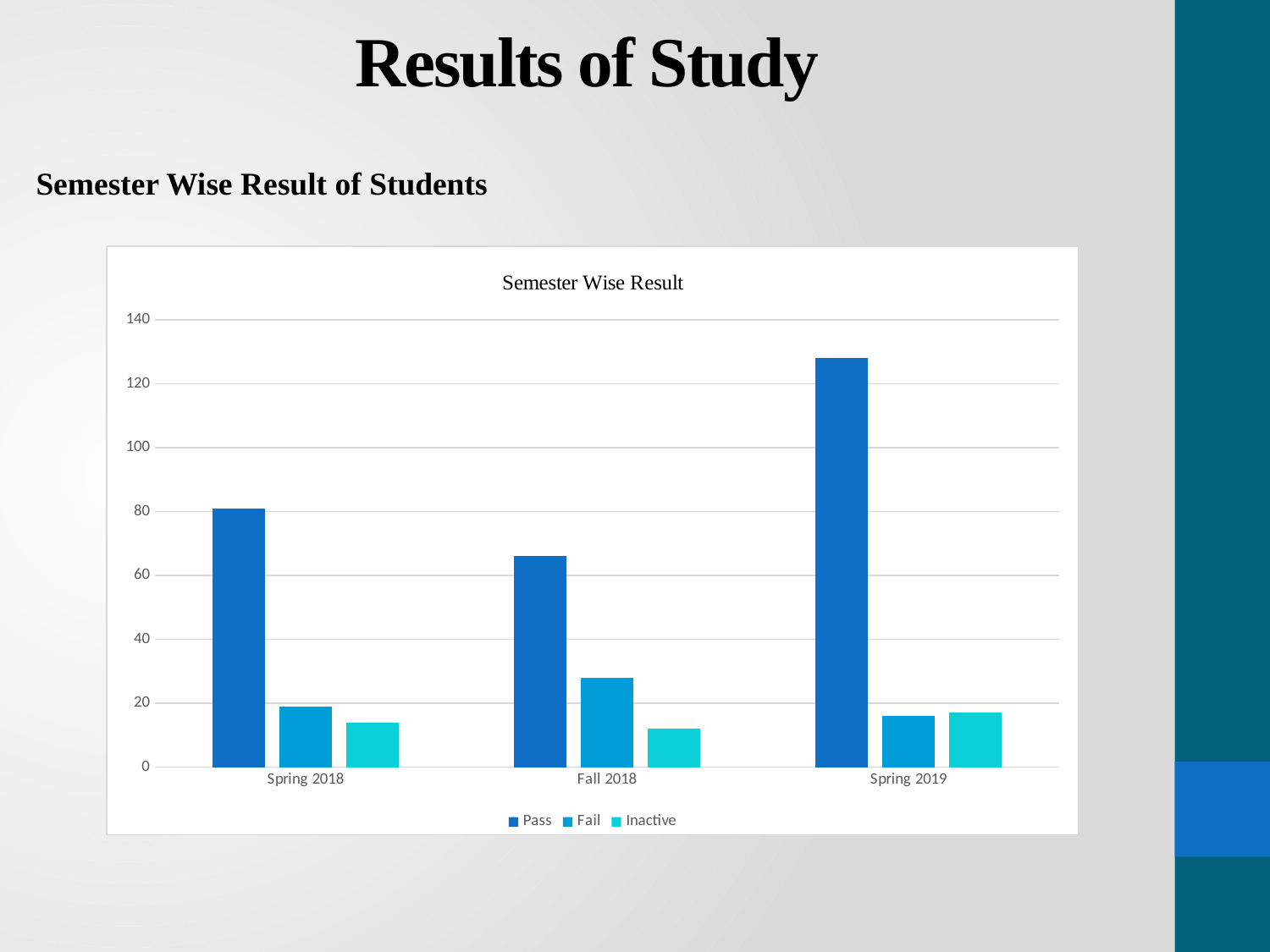
What is the title of the chart? Semester Wise Result What type of chart is shown on the slide? bar chart How many series does the legend list? 3 Which is larger, the Pass value for Spring 2018 or the Pass value for Fall 2018? Spring 2018 Which semester has the lowest Pass value? Fall 2018 Is the Inactive value for Spring 2018 greater or less than 20? less Is the Fail value for Fall 2018 greater or less than 20? greater Which semester has the highest Fail value? Fall 2018 Which semester has the highest Pass value? Spring 2019 Is the Pass value for Spring 2018 greater or less than 100? less How many semesters are shown on the x axis? 3